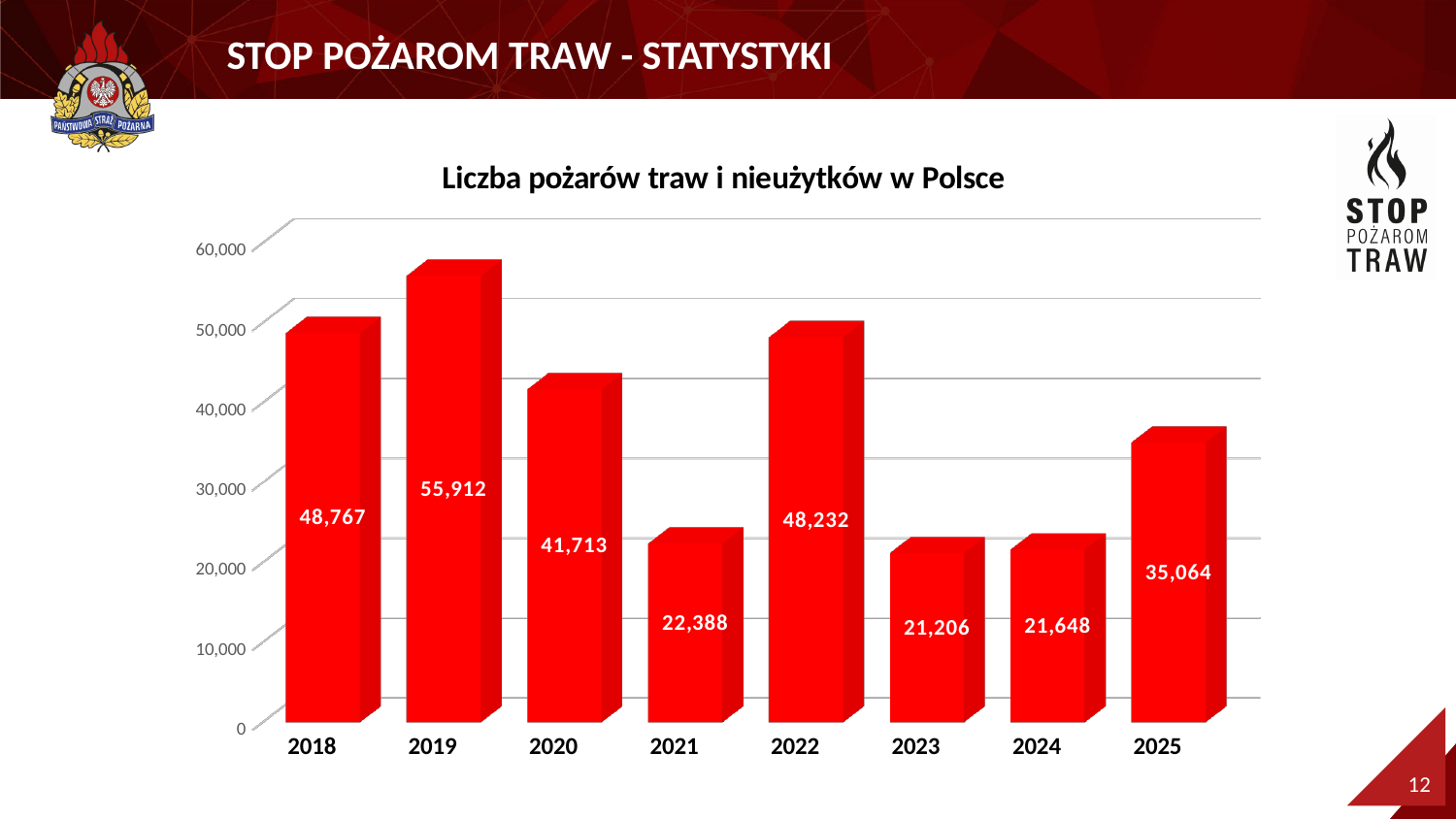
What is the title of the chart? Liczba pożarów traw i nieużytków w Polsce What is the value for 2023? 21,206 What is the value for 2025? 35,064 Which year has the lowest number of grass fires? 2023 What is the value for 2019? 55,912 How many years are shown on the x axis? 8 Which year has the highest number of grass fires? 2019 What is the difference between the values for 2019 and 2020? 14,199 Is the value for 2021 greater or less than 30,000? less What is the difference between the values for 2022 and 2023? 27,026 What kind of chart is shown on the slide? bar chart Which is larger, the value for 2018 or the value for 2022? 2018